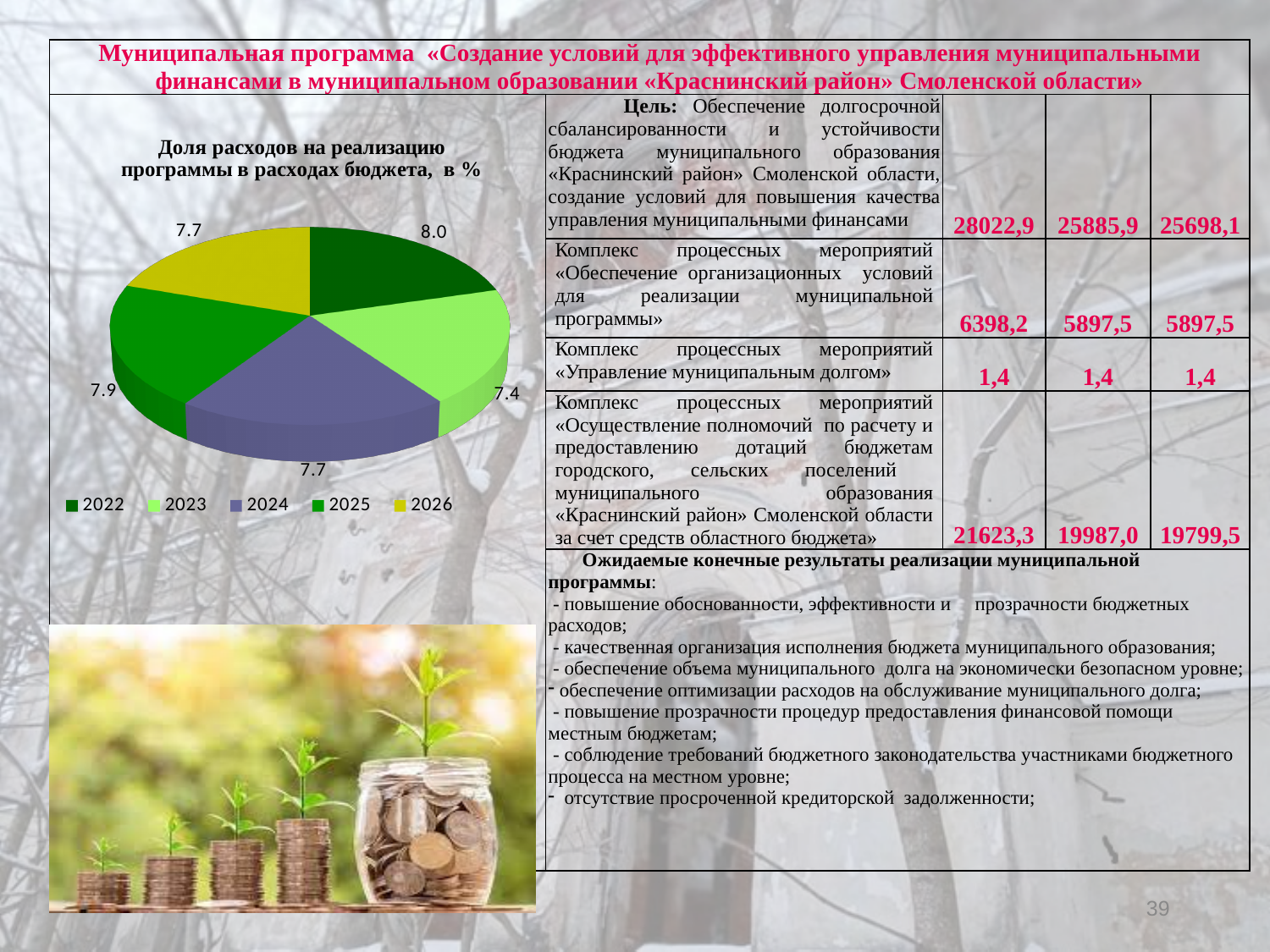
Which year has the lowest value in the pie chart? 2023 Which is larger in the pie chart, the value for 2025 or the value for 2023? 2025 What is the difference between the values for 2022 and 2023 in the pie chart? 0.6 What is the value for 2025 in the pie chart? 7.9 What type of chart is shown on the slide? pie chart What is the value for 2023 in the pie chart? 7.4 How many slices does the pie chart have? 5 Which year has the highest value in the pie chart? 2022 What is the value for 2022 in the pie chart? 8.0 How many entries does the legend of the pie chart list? 5 What is the title of the chart on the slide? Доля расходов на реализацию программы в расходах бюджета, в % What is the value for 2026 in the pie chart? 7.7